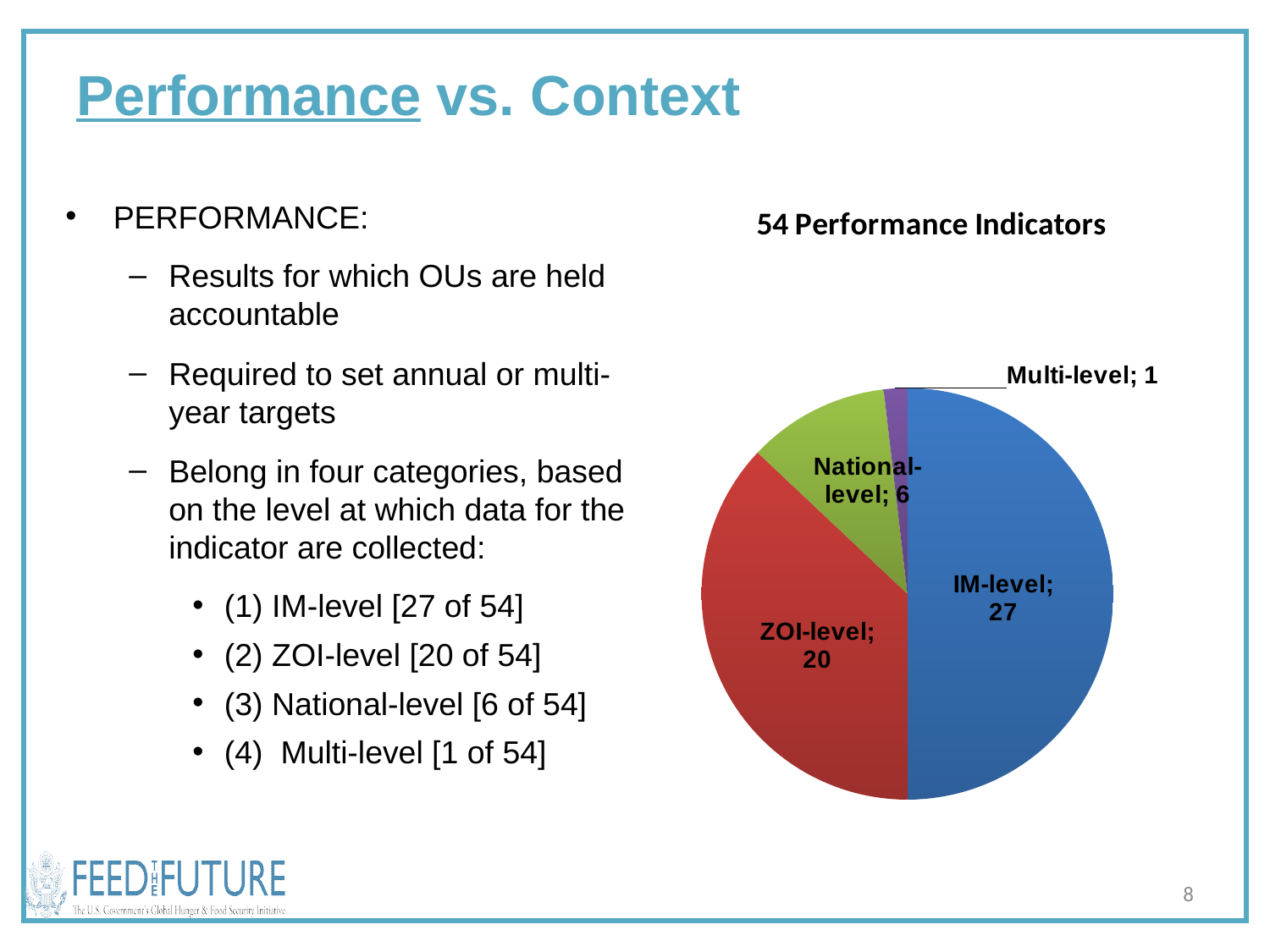
What is the value for National-level in the pie chart? 6 What is the value for IM-level in the pie chart? 27 How many categories are shown in the pie chart? 4 What is the value for Multi-level in the pie chart? 1 Which is larger, the ZOI-level value or the National-level value? ZOI-level What kind of chart is shown on the slide? Pie chart What is the value for ZOI-level in the pie chart? 20 What share of the pie does IM-level represent? 50% What is the difference between the IM-level and ZOI-level values? 7 What is the title of the pie chart? 54 Performance Indicators Which category has the largest slice in the pie chart? IM-level Which category has the smallest slice in the pie chart? Multi-level